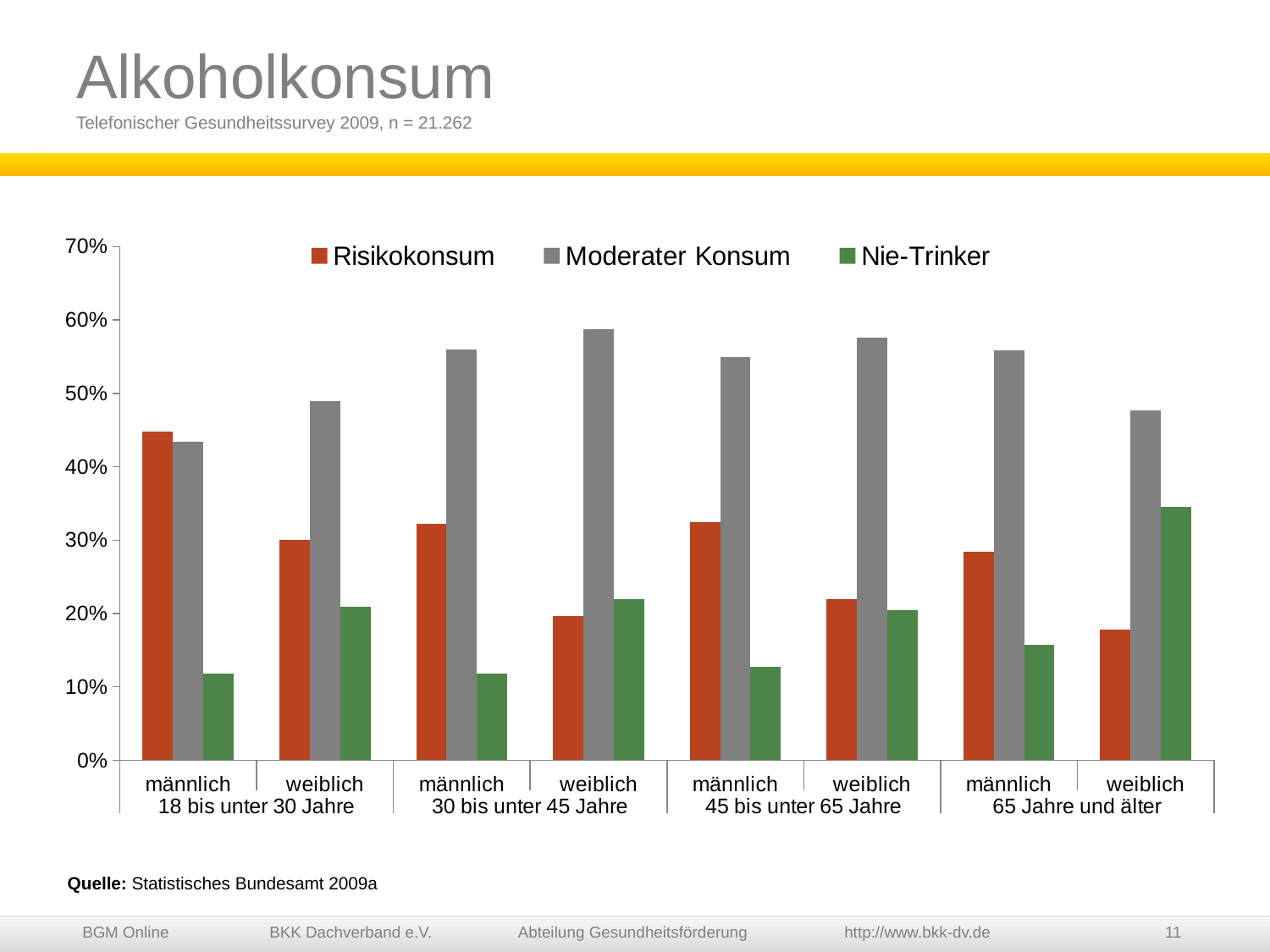
In the 30 bis unter 45 Jahre group, which has the larger Risikokonsum value: männlich or weiblich? männlich What kind of chart is shown on the slide? bar chart Is the Nie-Trinker value for weiblich, 65 Jahre und älter greater or less than 30%? greater How many series does the legend list? 3 Which group has the highest Nie-Trinker value? weiblich, 65 Jahre und älter What are the three series named in the legend? Risikokonsum, Moderater Konsum, Nie-Trinker Which group has the highest Risikokonsum value? männlich, 18 bis unter 30 Jahre Is the Risikokonsum value for männlich, 18 bis unter 30 Jahre greater or less than 40%? greater Is the Moderater Konsum value for männlich, 30 bis unter 45 Jahre greater or less than 50%? greater How many groups of bars (gender/age combinations) are shown on the x axis? 8 For weiblich, 65 Jahre und älter, which is larger: Risikokonsum or Nie-Trinker? Nie-Trinker How many age groups are shown along the x axis? 4